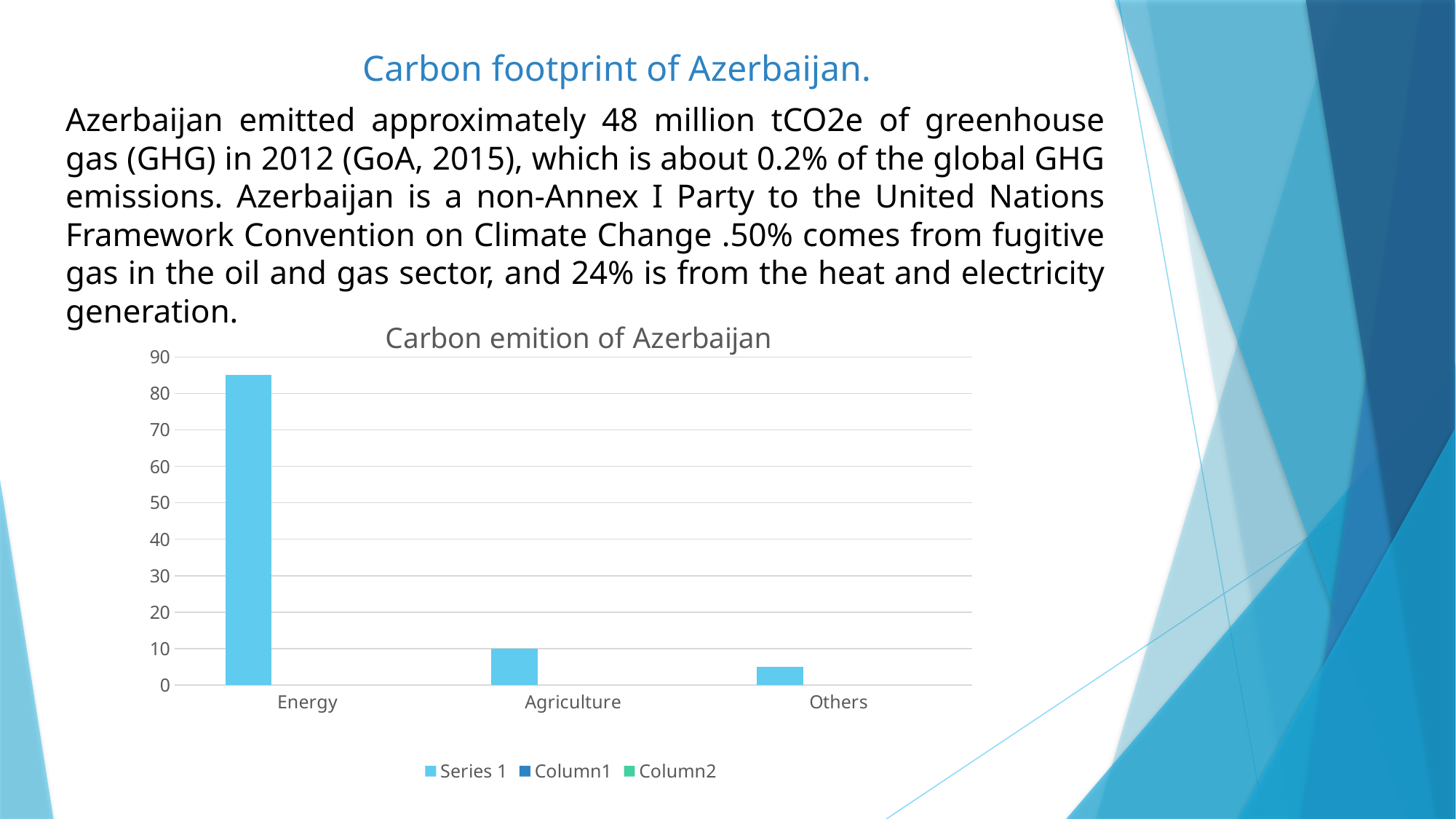
What is the title of the chart? Carbon emition of Azerbaijan How many series does the chart's legend list? 3 Which category has the highest value in the chart? Energy Is the value for Energy greater or less than 80? greater Do the values rise or fall from left to right across the categories? fall How many categories are shown on the x axis of the chart? 3 Is the value for Others greater or less than 10? less Which category has the lowest value in the chart? Others Which is larger, the value for Energy or the value for Agriculture? Energy What kind of chart is shown on the slide? bar chart What is the value for Agriculture in the chart? 10 Which is larger, the value for Agriculture or the value for Others? Agriculture